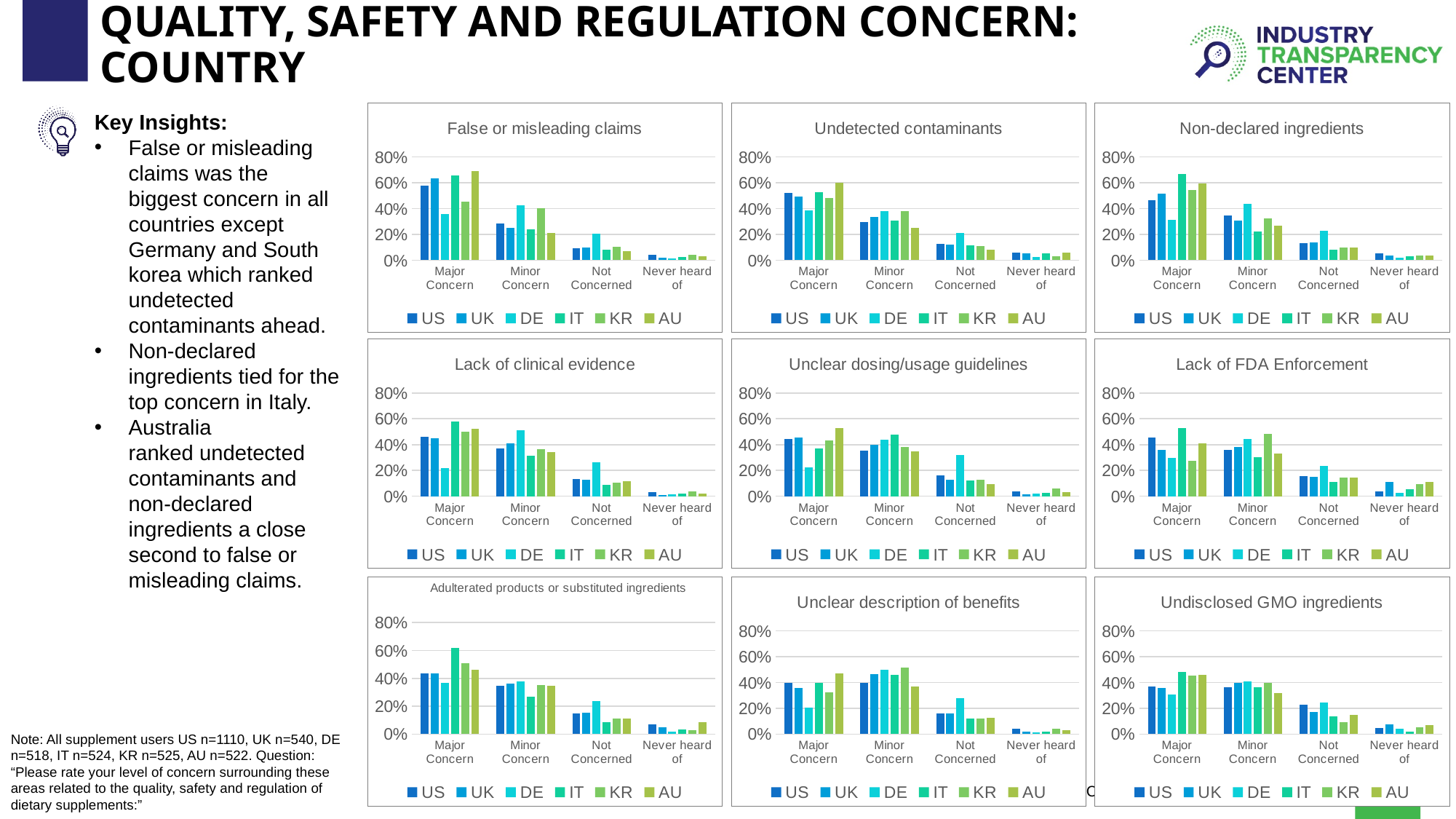
In the 'Non-declared ingredients' chart, which country has the lowest Major Concern value? DE What is the title of the bottom-left chart on the slide? Adulterated products or substituted ingredients What kind of chart is the 'False or misleading claims' chart? bar chart In the 'Lack of FDA Enforcement' chart, which country has the highest Major Concern value? IT How many series does the legend of the 'Undetected contaminants' chart list? 6 In the 'Undetected contaminants' chart, is the Minor Concern value for AU greater or less than 40%? less In the 'Unclear description of benefits' chart, which is larger for Minor Concern: AU or US? US In the 'Unclear dosing/usage guidelines' chart, is the Not Concerned value for DE greater or less than 20%? greater In the 'False or misleading claims' chart, is the Major Concern value for AU greater or less than 60%? greater How many categories are shown on the x axis of the 'Lack of clinical evidence' chart? 4 In the 'Lack of clinical evidence' chart, which is larger for Major Concern: IT or DE? IT In the 'Non-declared ingredients' chart, which country has the highest Major Concern value? IT